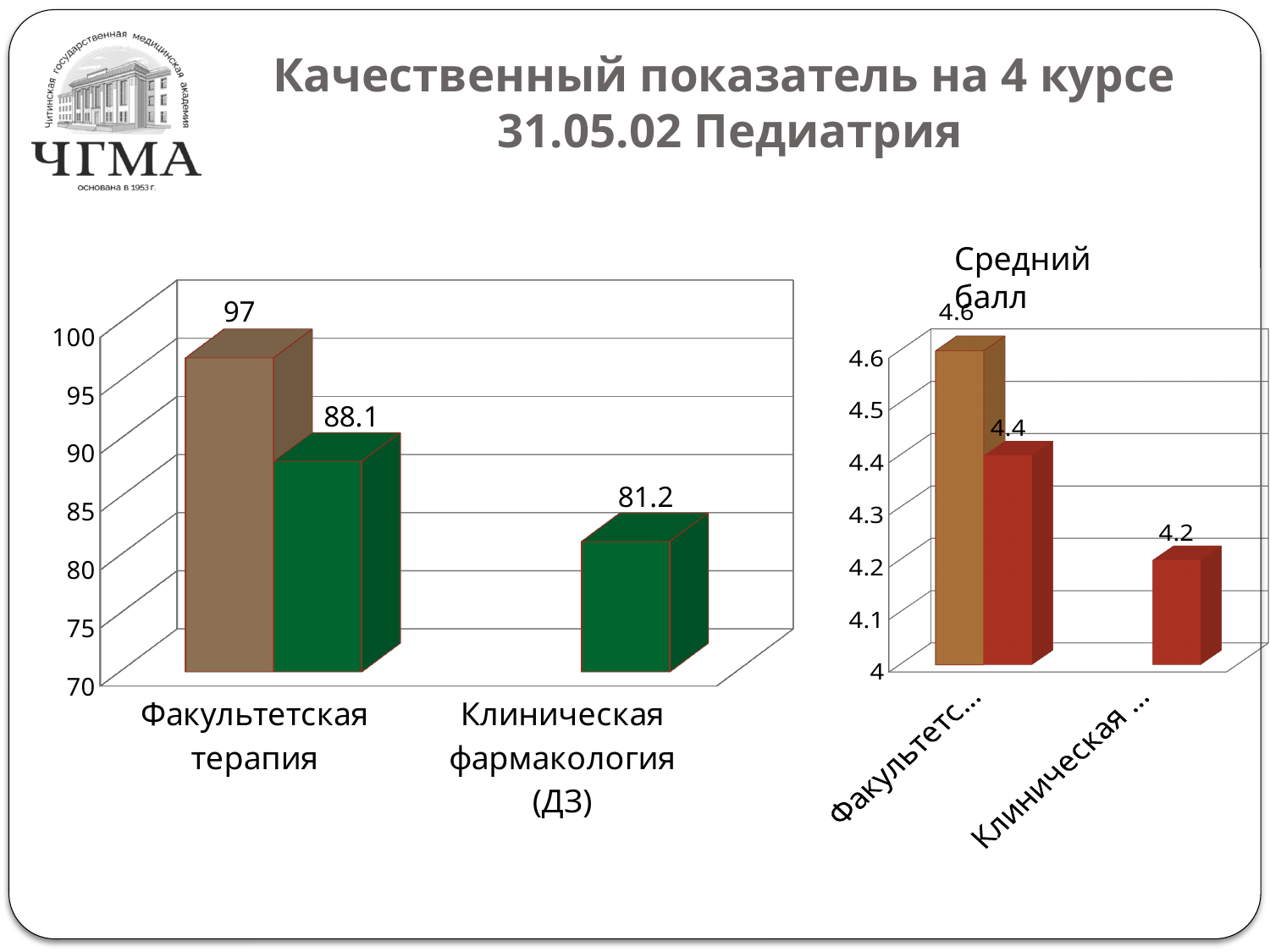
In the chart titled Средний балл, what is the value of the brown bar for the first category? 4.6 What is the title of the right chart? Средний балл In the chart titled Средний балл, what is the value of the red bar for the second category (Клиническая ...)? 4.2 In the left chart, which bar has the lowest value? Клиническая фармакология (ДЗ), 81.2 In the left chart, what is the difference between the two bars for Факультетская терапия (97 and 88.1)? 8.9 In the left chart, is the green bar for Факультетская терапия larger or smaller than the bar for Клиническая фармакология (ДЗ)? larger What type of chart is the left chart? bar chart In the left chart, how many categories are shown on the x axis? 2 In the left chart, what is the value of the brown bar for Факультетская терапия? 97 In the chart titled Средний балл, what is the difference between the highest value (4.6) and the lowest value (4.2)? 0.4 In the left chart, what is the value shown for Клиническая фармакология (ДЗ)? 81.2 In the left chart, what is the value of the green bar for Факультетская терапия? 88.1